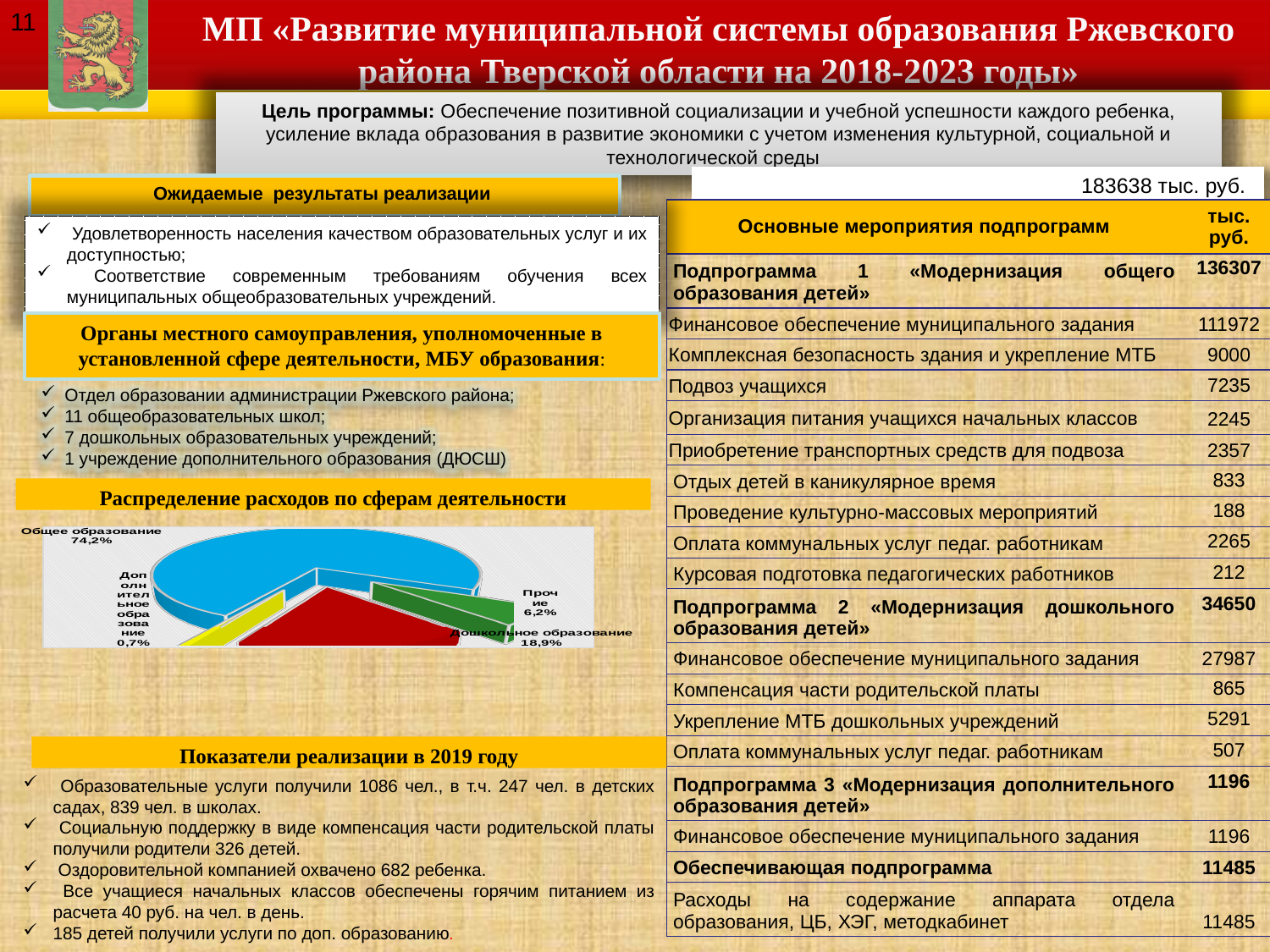
What share of expenses does the pie chart show for Прочие? 6,2% What is the difference in percentage points between the Общее образование and Дошкольное образование slices? 55,3 Which category has the largest slice in the pie chart? Общее образование What share of expenses does the pie chart show for Дошкольное образование? 18,9% What type of chart is used to show the distribution of expenses by sphere of activity? Pie chart How many slices does the pie chart have? 4 What share of expenses does the pie chart show for Дополнительное образование? 0,7% What share of expenses does the pie chart show for Общее образование? 74,2% What is the difference in percentage points between the Прочие and Дополнительное образование slices? 5,5 Which category has the smallest slice in the pie chart? Дополнительное образование Which slice is larger in the pie chart: Дошкольное образование or Прочие? Дошкольное образование What is the title of the chart on the slide? Распределение расходов по сферам деятельности